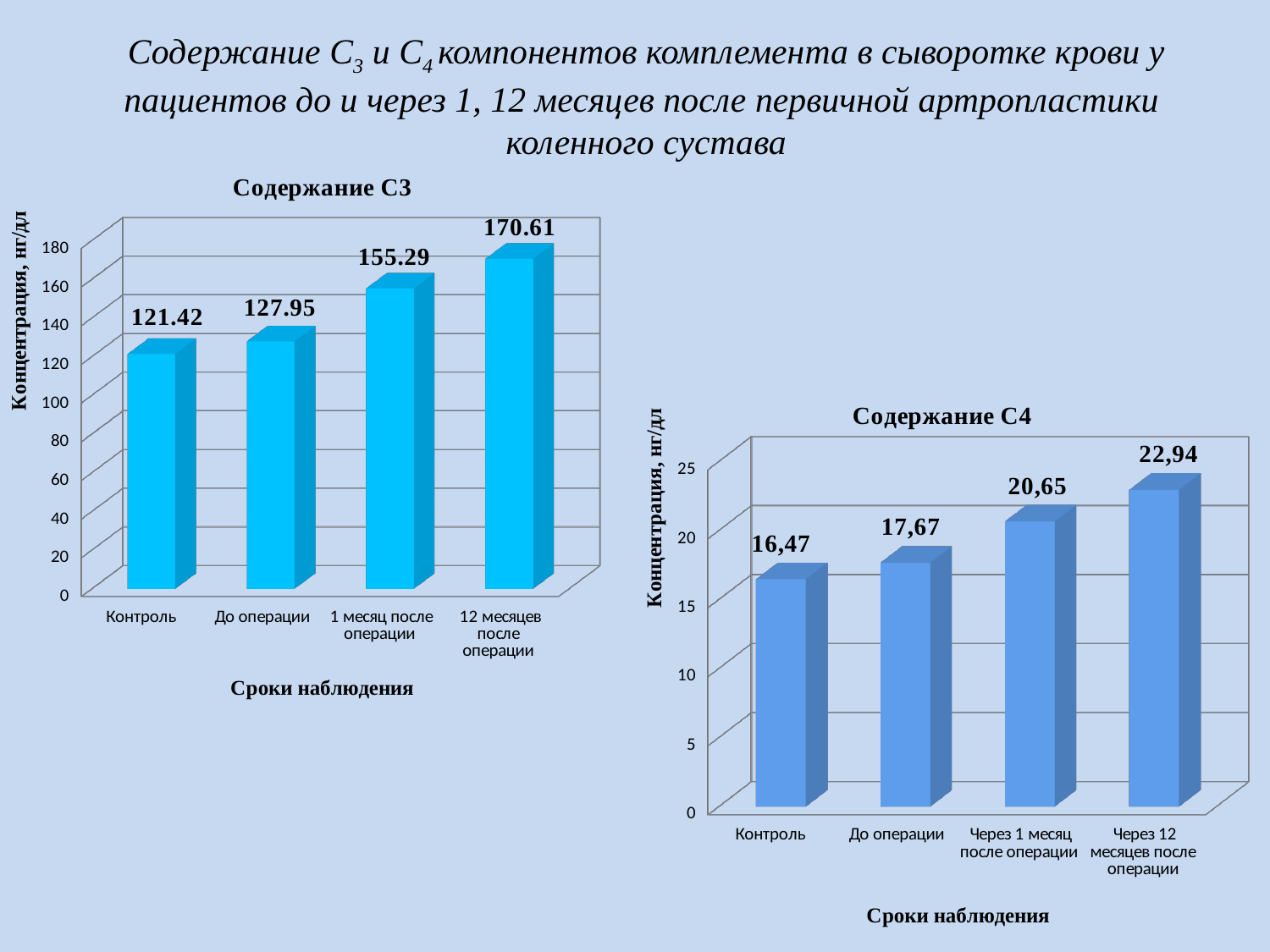
In the "Содержание С4" chart, do the values rise or fall from left to right along the x axis? Rise What kind of chart is the "Содержание С3" chart? Bar chart In the "Содержание С4" chart, what is the value for "Через 12 месяцев после операции"? 22,94 How many categories are shown on the x axis of the "Содержание С4" chart? 4 In the "Содержание С4" chart, what is the value for "До операции"? 17,67 In the "Содержание С3" chart, which is larger: the value for "До операции" or the value for "1 месяц после операции"? 1 месяц после операции In the "Содержание С4" chart, which category has the lowest value? Контроль In the "Содержание С4" chart, what is the difference between the values for "Через 1 месяц после операции" and "До операции"? 2,98 In the "Содержание С3" chart, what is the value for "1 месяц после операции"? 155.29 In the "Содержание С3" chart, what is the value for "Контроль"? 121.42 In the "Содержание С3" chart, what is the difference between the values for "12 месяцев после операции" and "Контроль"? 49.19 In the "Содержание С3" chart, which category has the highest value? 12 месяцев после операции